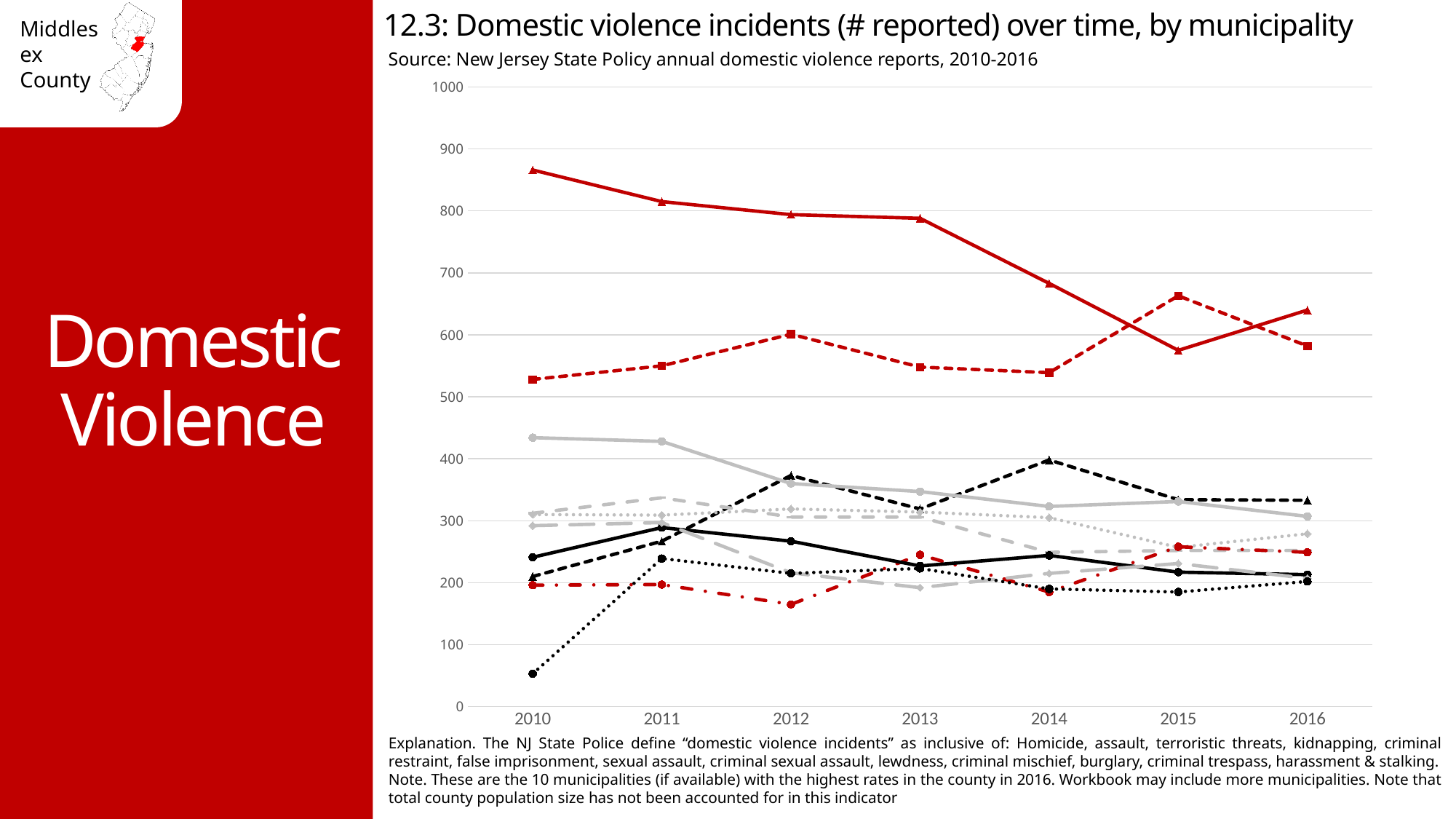
What kind of chart is shown on the slide? line chart What is the title of the chart? 12.3: Domestic violence incidents (# reported) over time, by municipality Is the 2015 value of the dashed red line with square markers greater or less than 600? greater Is the 2010 value of the dotted black line with circle markers greater or less than 100? less What is the highest value labelled on the vertical axis? 1000 Is the 2016 value of the solid red line with triangle markers greater or less than 700? less Does the solid red line with triangle markers rise or fall from 2010 to 2015? fall How many years are shown along the x axis of the chart? 7 In which year does the solid red line with triangle markers reach its lowest value? 2015 In 2015, which is higher: the solid red line with triangle markers or the dashed red line with square markers? the dashed red line with square markers